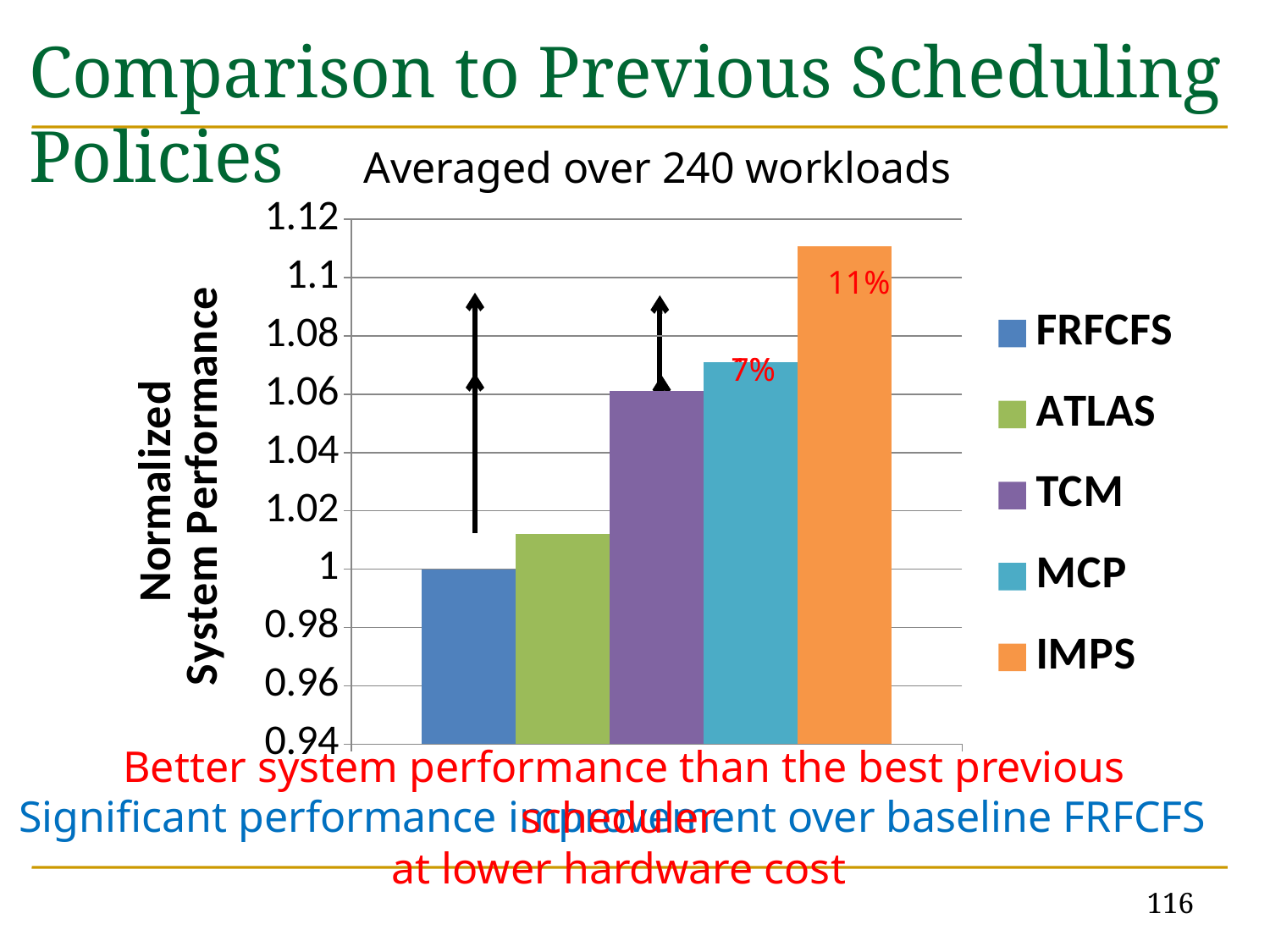
Is the normalized system performance for TCM greater or less than 1.04? greater Do the bars rise or fall from left to right across the chart? rise What is the title shown above the chart? Averaged over 240 workloads Is the normalized system performance for ATLAS greater or less than 1.02? less Which scheduling policy has the highest normalized system performance? IMPS Is the normalized system performance for IMPS greater or less than 1.1? greater What kind of chart is shown on the slide? bar chart What colour is the IMPS bar? orange Which has a higher normalized system performance, ATLAS or TCM? TCM How many series does the legend list? 5 Which scheduling policy has the lowest normalized system performance? FRFCFS What is the normalized system performance of FRFCFS? 1